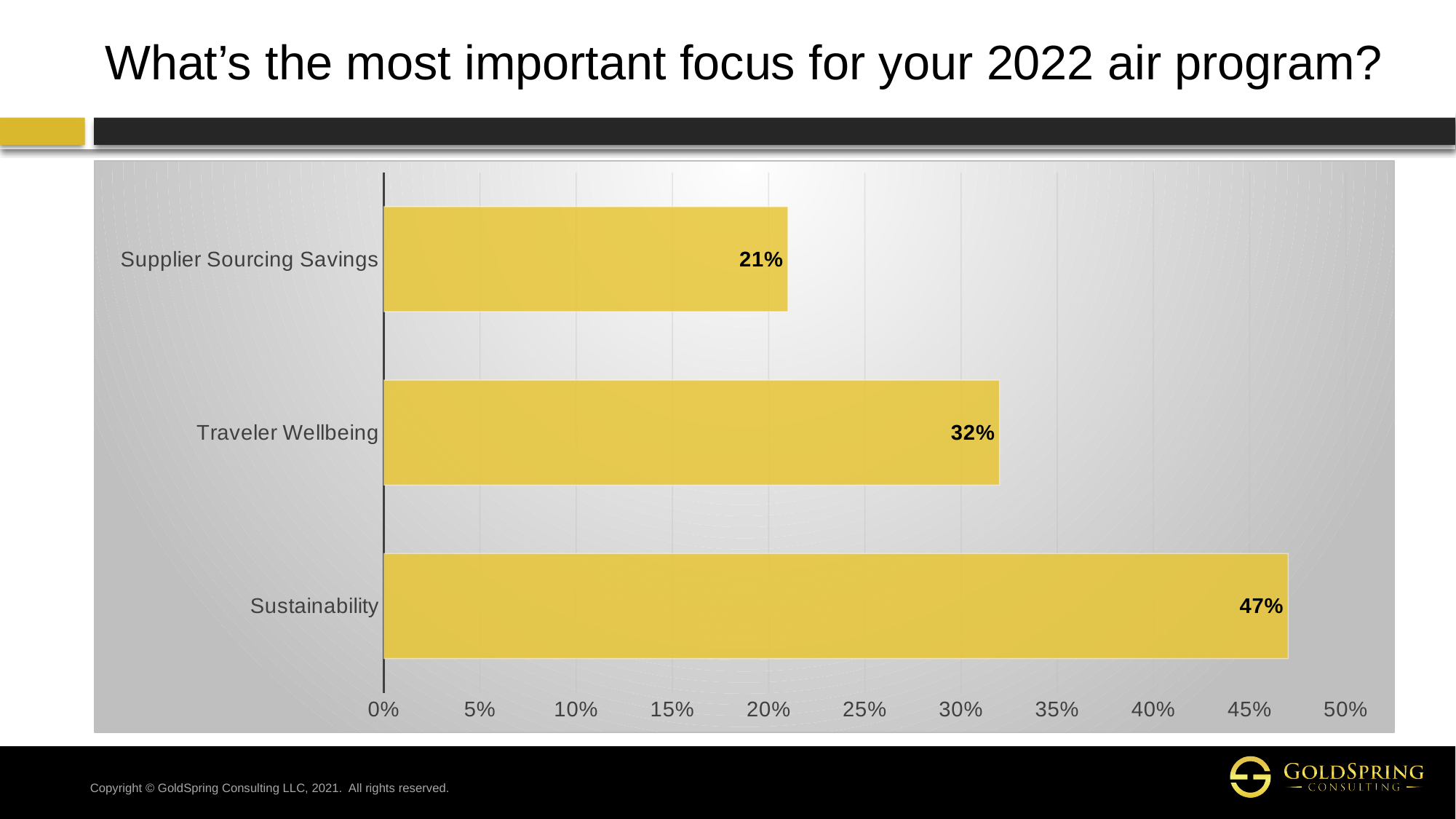
Which is larger, the value for Traveler Wellbeing or the value for Supplier Sourcing Savings? Traveler Wellbeing What is the title of the slide? What's the most important focus for your 2022 air program? Which category has the highest value? Sustainability Is the value for Sustainability greater or less than 40%? greater How many categories are shown in the chart? 3 What is the value for Supplier Sourcing Savings? 21% What kind of chart is shown on the slide? Bar chart What is the value for Sustainability? 47% What is the difference between the values for Sustainability and Traveler Wellbeing? 15% Which category has the lowest value? Supplier Sourcing Savings What is the difference between the values for Traveler Wellbeing and Supplier Sourcing Savings? 11% What is the value for Traveler Wellbeing? 32%